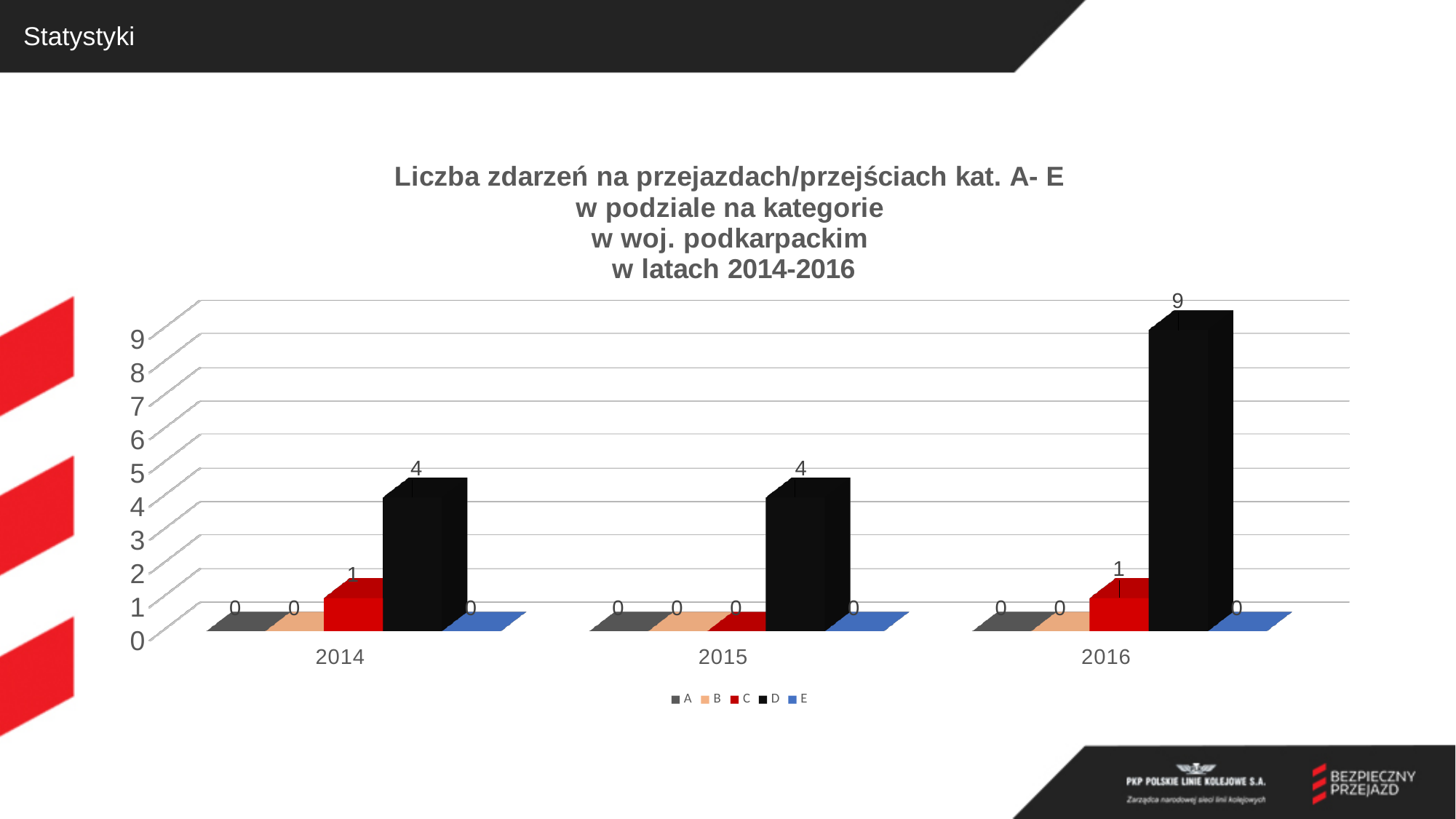
How many years are shown on the x axis? 3 Which is larger: the value for series D in 2014 or the value for series C in 2014? D in 2014 In which year does series D reach its highest value? 2016 What is the value for series D in 2015? 4 What is the total of all series values for 2016? 10 What is the value for series C in 2014? 1 How many series does the legend list? 5 What is the difference between the value for series D in 2016 and in 2015? 5 What is the value for series C in 2015? 0 What kind of chart is shown on the slide? bar chart Which series is shown in red in the legend? C What is the value for series D in 2016? 9